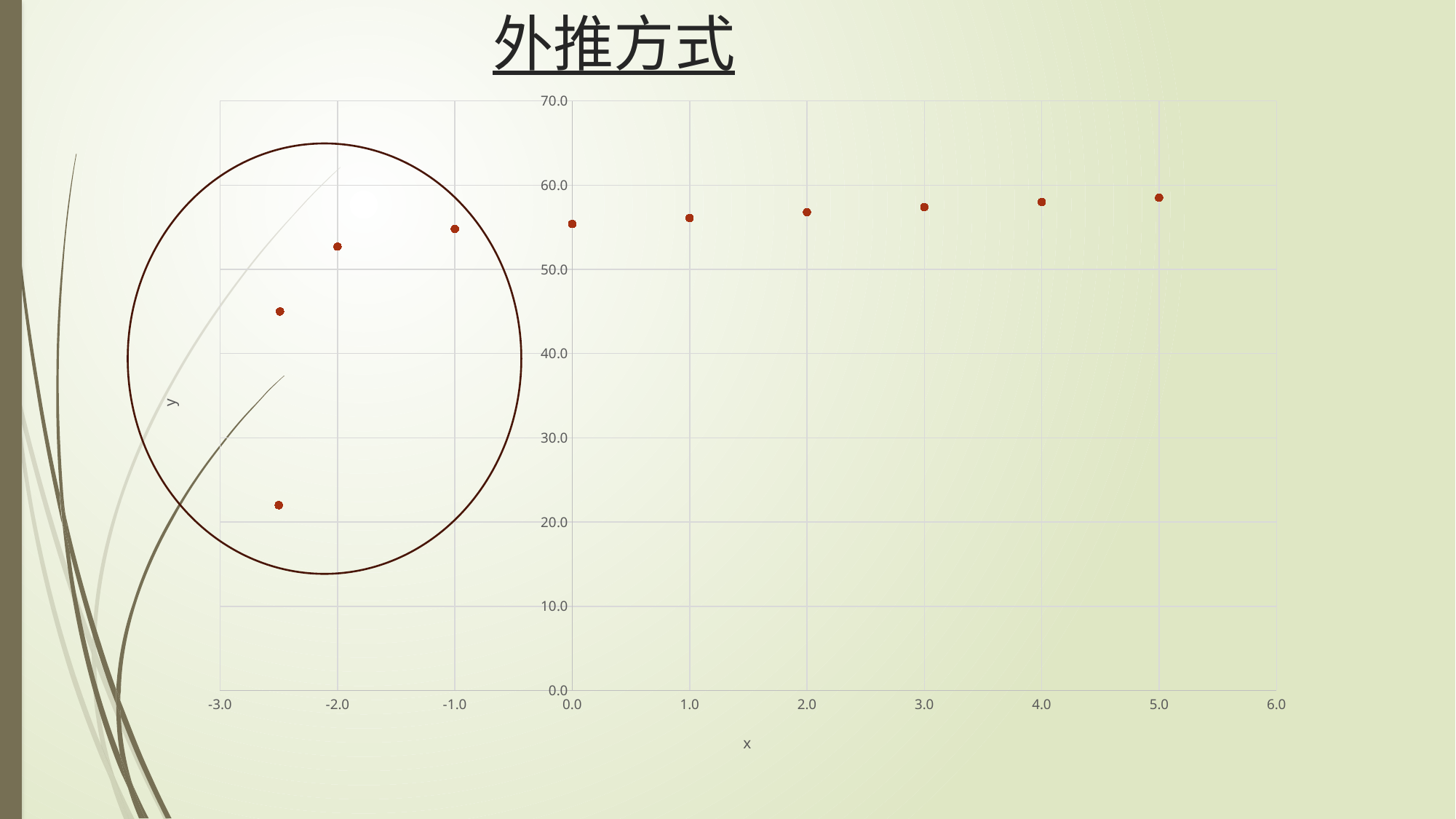
Is the value for x = 0.0 greater or less than 50? greater Is the value for x = -2.0 greater or less than 50? greater What are the labels of the x axis and y axis? x and y What kind of chart is shown on the slide? scatter chart Is the lowest point at x = -2.5 greater or less than 30? less What is the title of the slide/chart? 外推方式 Do the values rise or fall as x increases from 0.0 to 5.0? rise How many data points are plotted on the chart? 10 Which is larger, the value at x = 3.0 or the value at x = -2.0? x = 3.0 At which x value is the lowest point on the chart? -2.5